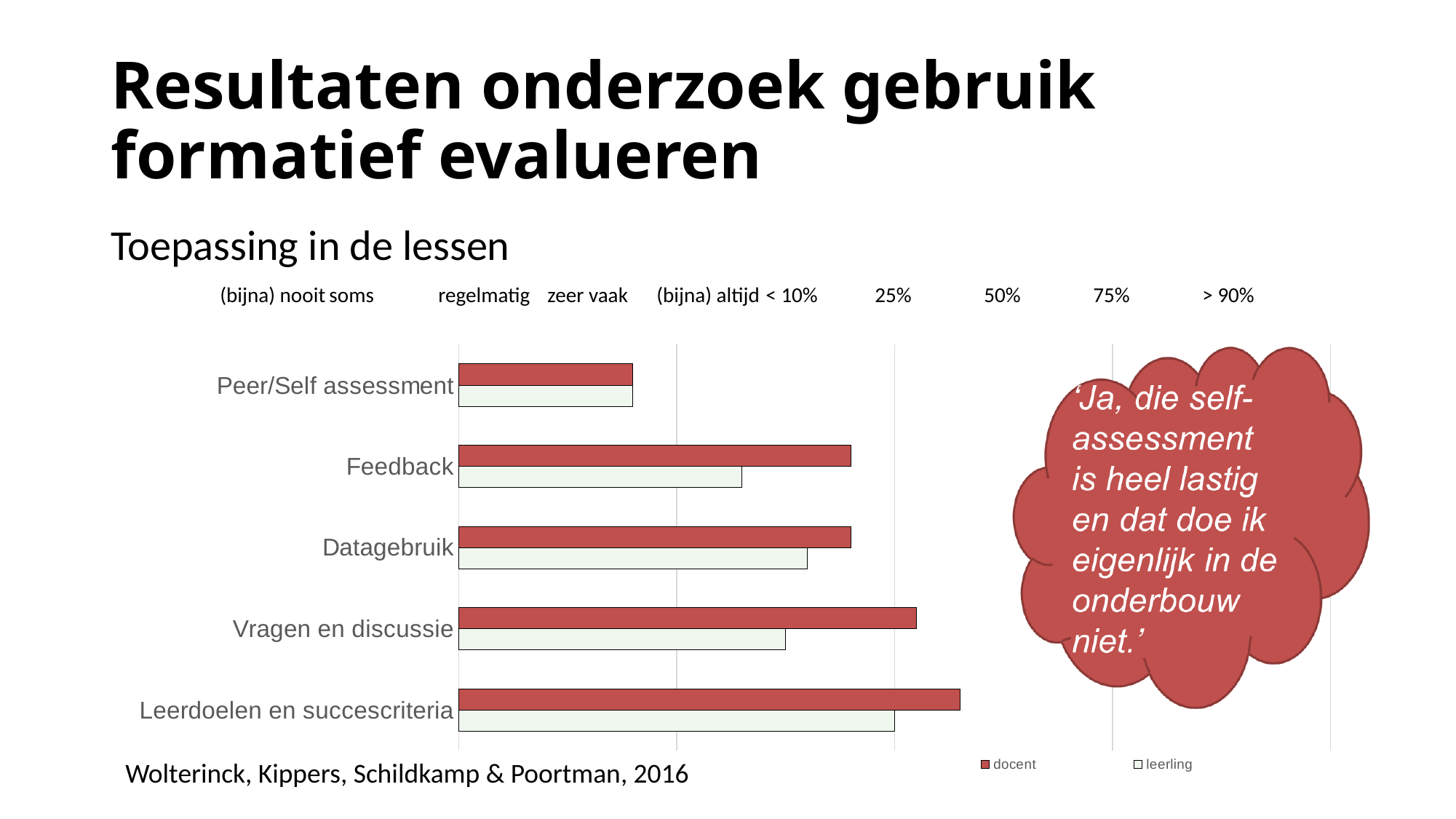
What are the two series named in the chart legend? docent and leerling Which category has the highest value for the docent series? Leerdoelen en succescriteria What kind of chart is shown on the slide? bar chart Which category has the highest value for the leerling series? Leerdoelen en succescriteria For Vragen en discussie, which series has the larger value, docent or leerling? docent Which category has the lowest value for the leerling series? Peer/Self assessment In the leerling series, which is larger: Datagebruik or Feedback? Datagebruik Which category has the lowest value for the docent series? Peer/Self assessment For Feedback, which series has the larger value, docent or leerling? docent How many categories are shown on the chart? 5 Which series is shown in red on the chart? docent How many series does the chart legend list? 2